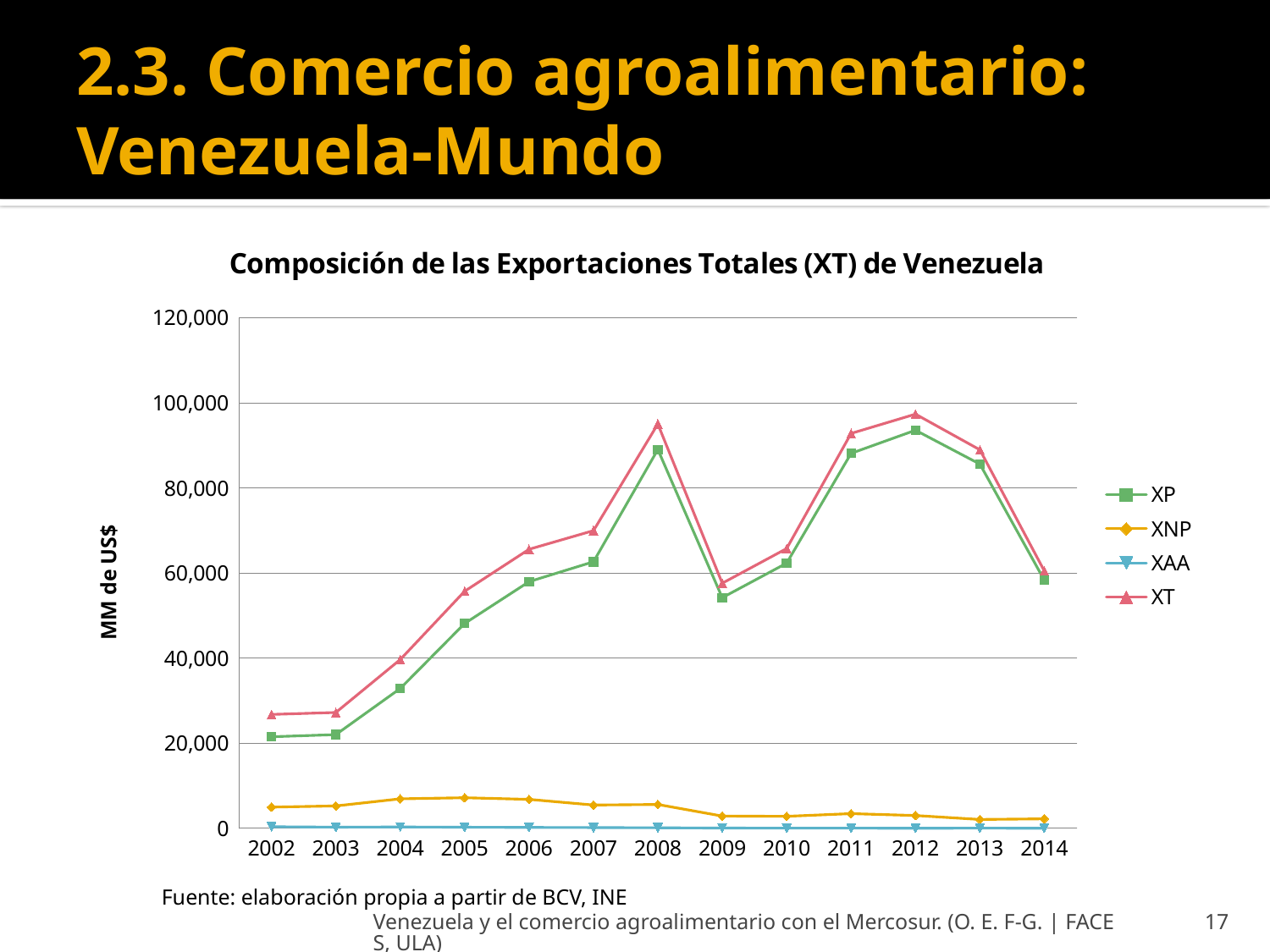
In which year does the XP series reach its highest value? 2012 How many series does the legend list? 4 Is the value of XNP in 2005 greater or less than 20,000? less What kind of chart is shown on the slide? Line chart Do the XP values rise or fall from 2012 to 2014? fall Is the value of XP in 2009 greater or less than 60,000? less Is the value of XT in 2008 greater or less than 80,000? greater Which series has the highest values throughout the chart? XT How many years are plotted along the x axis? 13 Which series has the lowest values throughout the chart? XAA What is the label of the y axis? MM de US$ Which is larger in 2011, XT or XP? XT